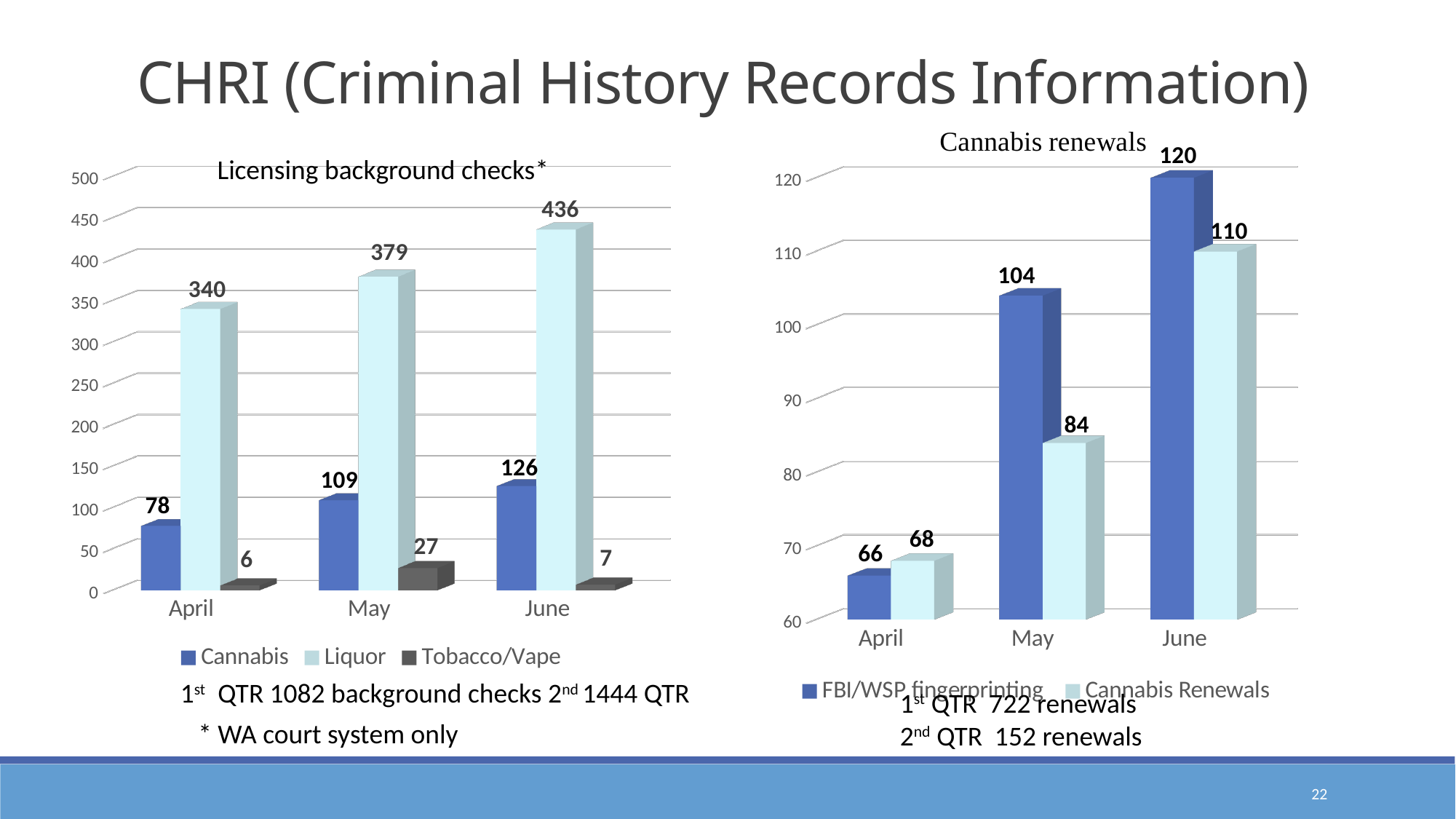
In the 'Licensing background checks*' chart, what is the difference between the Liquor and Cannabis values in April? 262 In the 'Cannabis renewals' chart, what is the difference between FBI/WSP fingerprinting and Cannabis Renewals in May? 20 In the 'Licensing background checks*' chart, which month has the lowest Tobacco/Vape value? April In the 'Licensing background checks*' chart, how many series does the legend list? 3 In the 'Cannabis renewals' chart, what is the FBI/WSP fingerprinting value for May? 104 In the 'Licensing background checks*' chart, which month has the highest Liquor value? June In the 'Licensing background checks*' chart, what is the value for Cannabis in June? 126 In the 'Cannabis renewals' chart, which is larger in April: FBI/WSP fingerprinting or Cannabis Renewals? Cannabis Renewals What kind of chart is the 'Cannabis renewals' chart? bar chart In the 'Licensing background checks*' chart, what is the value for Liquor in May? 379 In the 'Cannabis renewals' chart, what is the Cannabis Renewals value for June? 110 In the 'Licensing background checks*' chart, do the Cannabis values rise or fall from April to June? rise